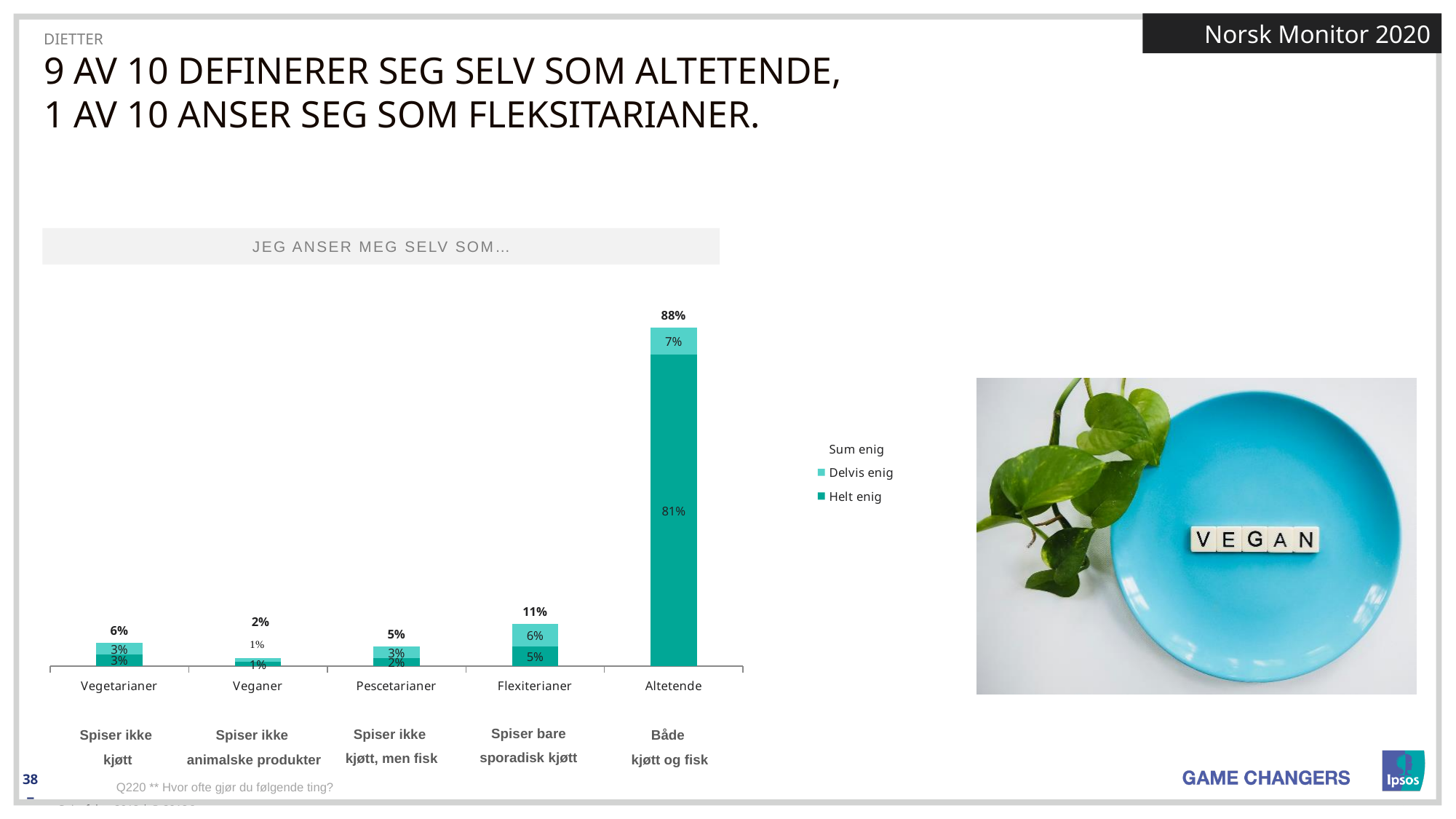
How many categories are shown on the x axis? 5 What is the total ('Sum enig') for Vegetarianer? 6% Which category has the highest total? Altetende Which is larger, the total for Pescetarianer or the total for Vegetarianer? Vegetarianer What kind of chart is shown? Stacked bar chart What is the 'Delvis enig' value for Flexiterianer? 6% What is the difference between the totals for Altetende and Flexiterianer? 77% What is the total ('Sum enig') for Flexiterianer? 11% How many entries does the legend list? 3 Which category has the lowest total? Veganer What is the 'Helt enig' value for Altetende? 81% What is the 'Helt enig' value for Pescetarianer? 2%